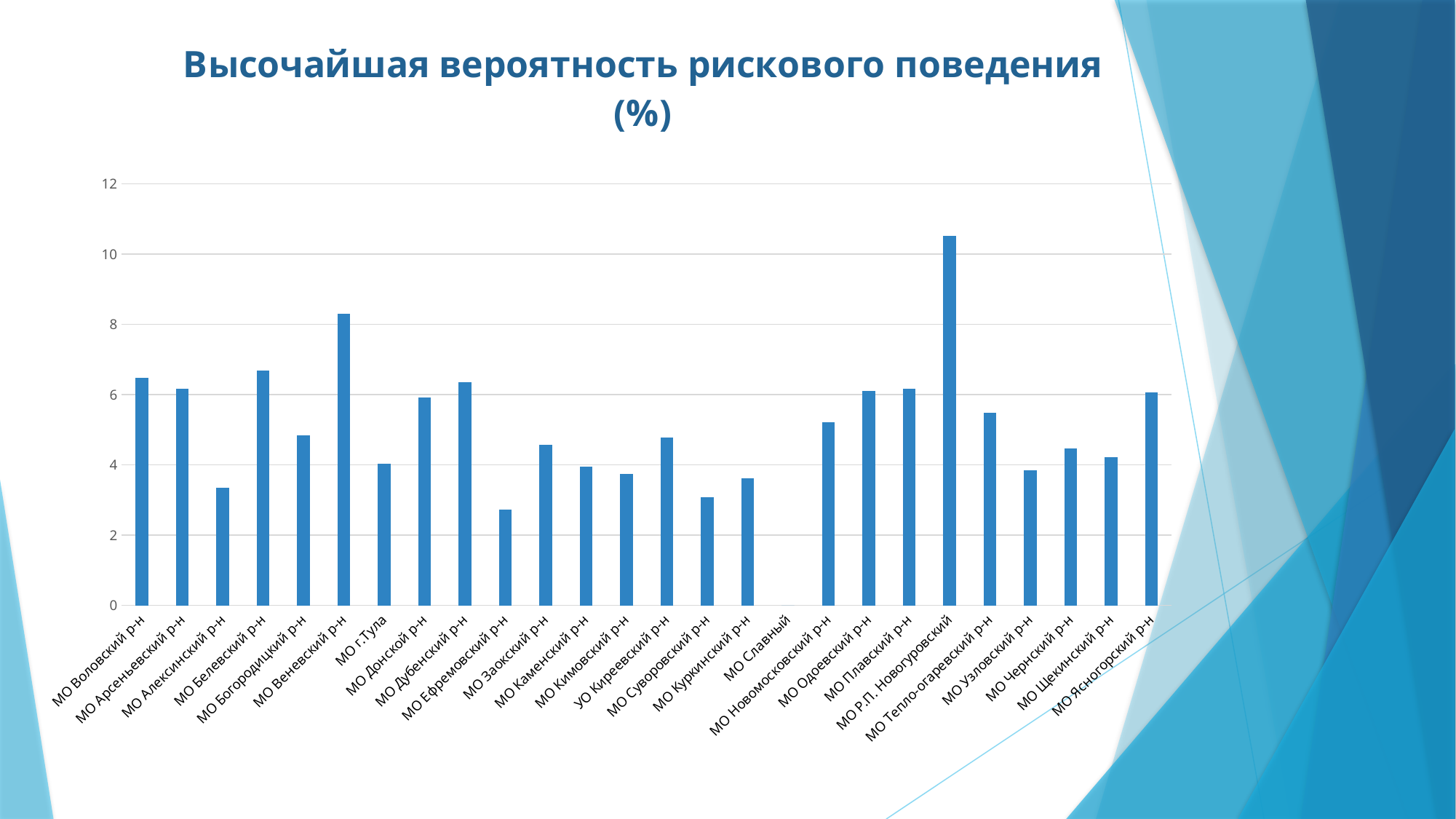
Is the value for МО Веневский р-н greater or less than 8? greater Is the value for МО Р.П. Новогуровский greater or less than 10? greater Is the value for МО Ефремовский р-н greater or less than 4? less Which category has the highest value in the chart? МО Р.П. Новогуровский Which has a larger value, МО Веневский р-н or МО Воловский р-н? МО Веневский р-н What is the title of the chart? Высочайшая вероятность рискового поведения (%) Which category has no visible bar in the chart? МО Славный How many categories are shown on the x axis of the chart? 26 What kind of chart is shown on the slide? bar chart Which has a larger value, МО г.Тула or МО Донской р-н? МО Донской р-н